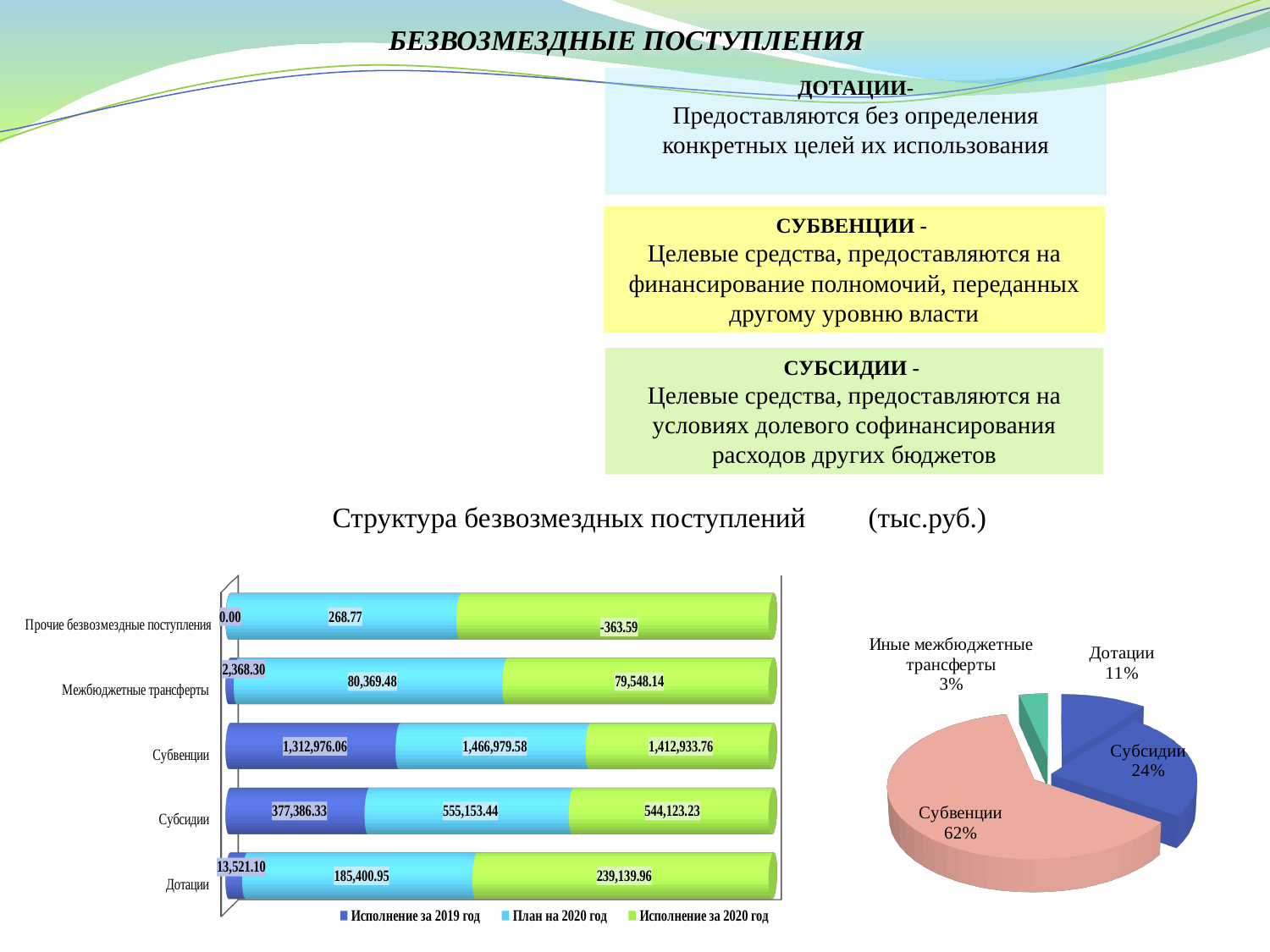
In the bar chart on the left, what is the difference between План на 2020 год and Исполнение за 2020 год for Дотации? 53,739.01 In the bar chart on the left, which is larger for Межбюджетные трансферты: План на 2020 год or Исполнение за 2020 год? План на 2020 год In the pie chart on the right, which slice is the smallest? Иные межбюджетные трансферты In the bar chart on the left, what is the value of Исполнение за 2020 год for Субсидии? 544,123.23 In the pie chart on the right, what share does Субвенции have? 62% What type of chart is shown on the right of the slide? Pie chart In the bar chart on the left, what is the value of План на 2020 год for Субвенции? 1,466,979.58 How many categories are shown in the bar chart on the left? 5 In the bar chart on the left, which category has the highest value for Исполнение за 2019 год? Субвенции How many series does the legend of the bar chart on the left list? 3 In the bar chart on the left, what is the value of Исполнение за 2020 год for Прочие безвозмездные поступления? -363.59 In the bar chart on the left, what is the value of Исполнение за 2019 год for Дотации? 13,521.10